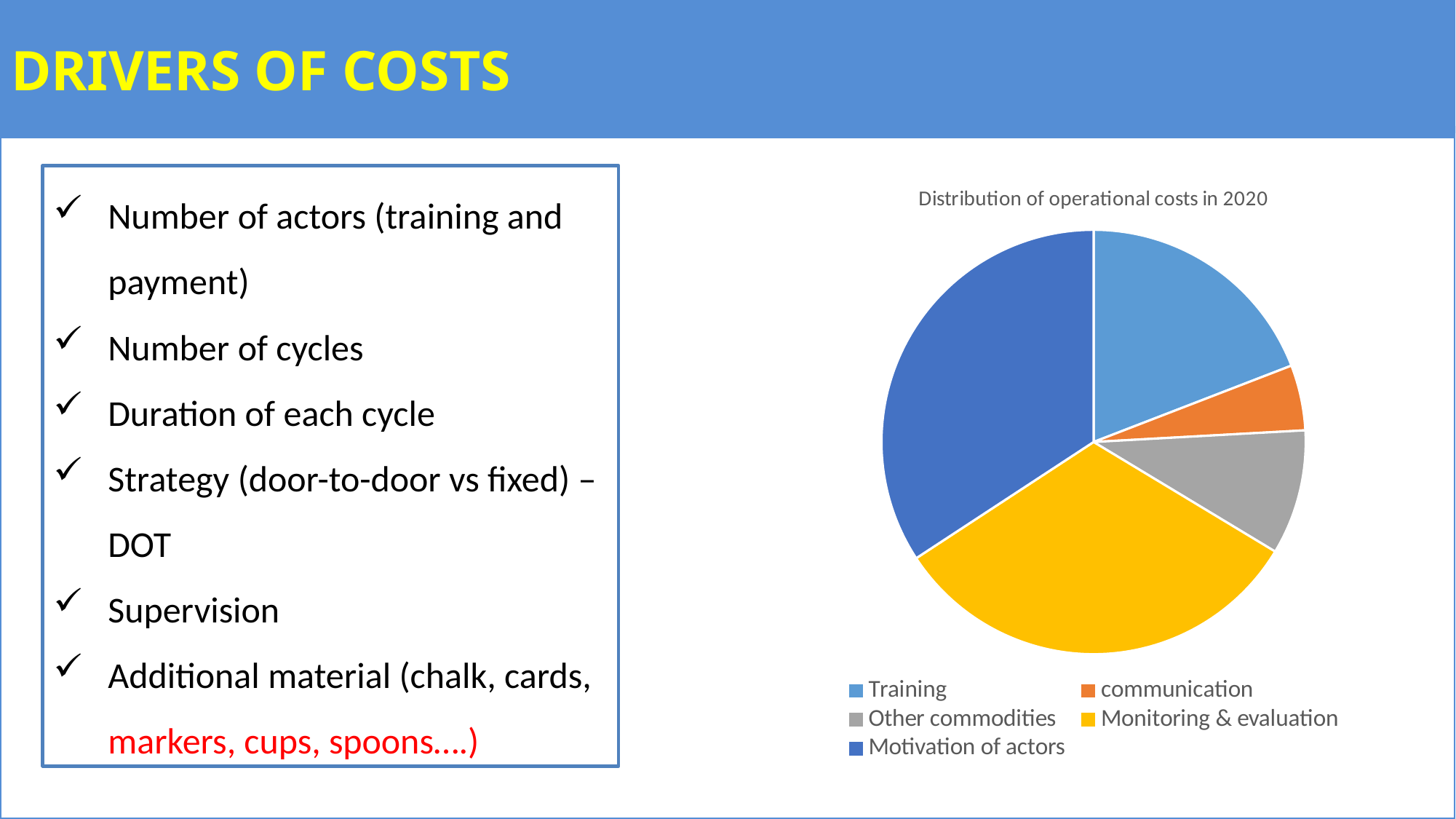
How many slices does the pie chart have? 5 What kind of chart is shown on the slide? pie chart Which slice is larger, Training or communication? Training What is the title of the chart? Distribution of operational costs in 2020 Which slice is larger, Training or Other commodities? Training How many categories does the pie chart legend list? 5 Which slice is larger, Motivation of actors or Training? Motivation of actors Which colour represents Monitoring & evaluation in the pie chart? yellow Which category has the smallest slice of the pie? communication